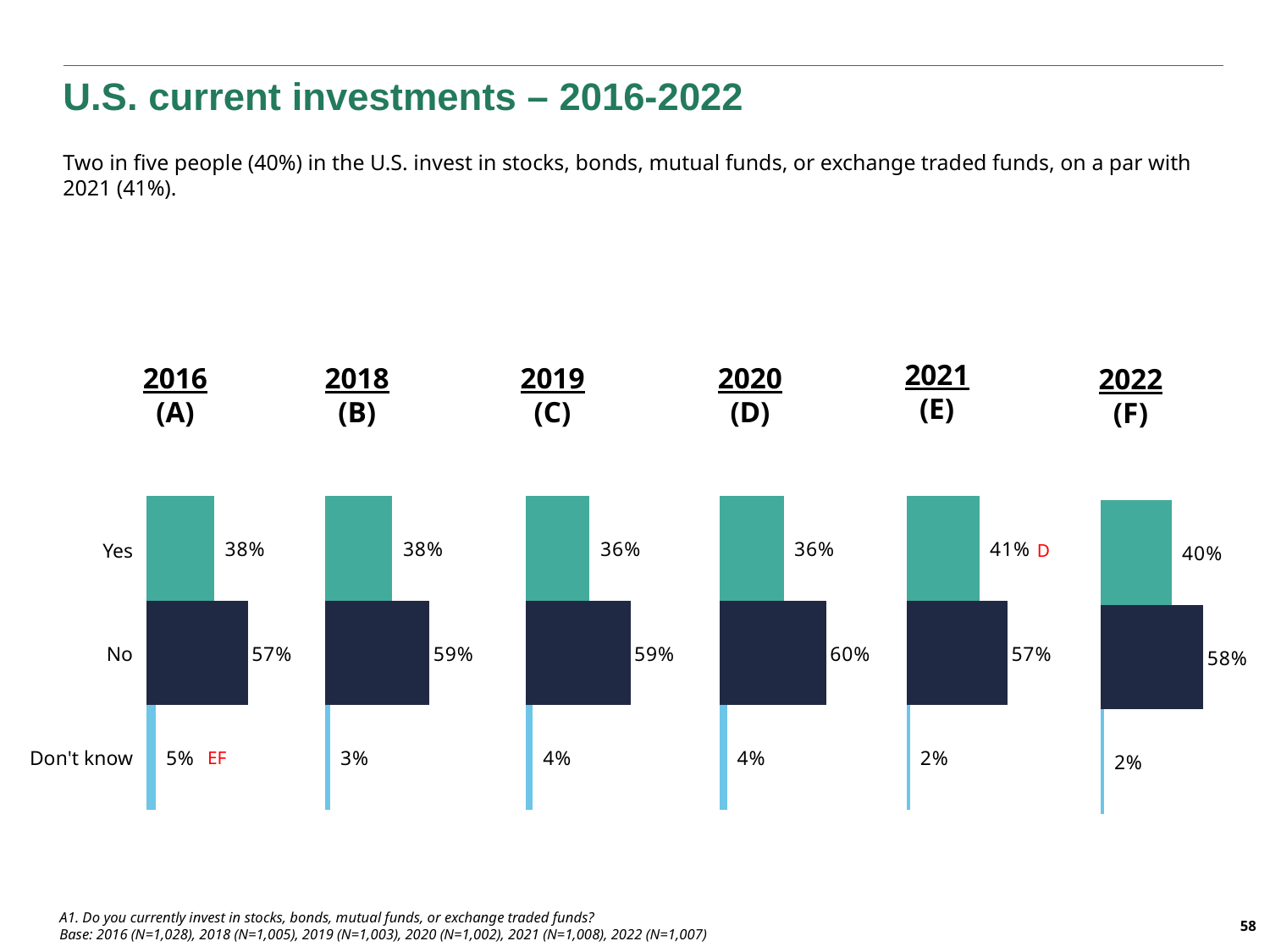
In the 2022 chart, what percentage answered Yes? 40% How many year charts are shown on the slide? 6 Across the six year charts, which year has the highest Yes percentage? 2021 What type of chart is used to show the results for each year? Bar chart In the 2016 chart, what percentage answered Don't know? 5% What is the title of the slide containing the charts? U.S. current investments – 2016-2022 In the 2020 chart, what percentage answered No? 60% In the 2022 chart, which is larger, the Yes or the No percentage? No In the 2021 chart, what percentage answered No? 57% In the 2019 chart, what is the difference between the No and Yes percentages? 23% Across the six year charts, which year has the lowest Don't know percentage, 2016 or 2021? 2021 How many response categories are shown in each year's chart? 3